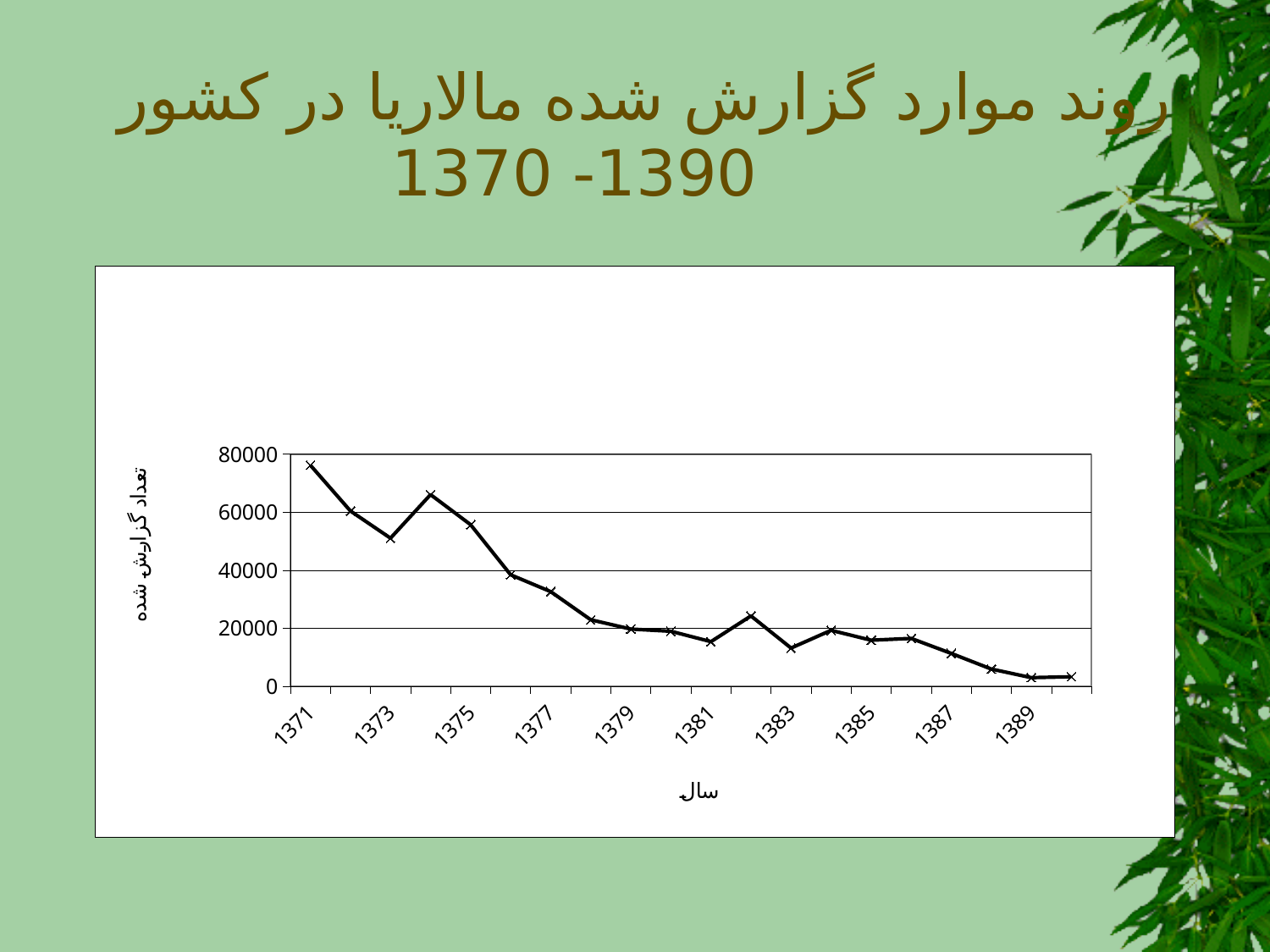
Is the value for 1388 greater or less than 20000? less Which is larger, the value for 1371 or the value for 1373? 1371 Which year has the highest number of reported cases? 1371 Is the value for 1373 greater or less than 40000? greater Is the value for 1371 greater or less than 60000? greater Do the reported malaria cases generally rise or fall from 1371 to 1390? fall What kind of chart is shown on the slide? line chart How many data points are plotted on the line? 20 What is the label on the x axis of the chart? سال Which is larger, the value for 1374 or the value for 1376? 1374